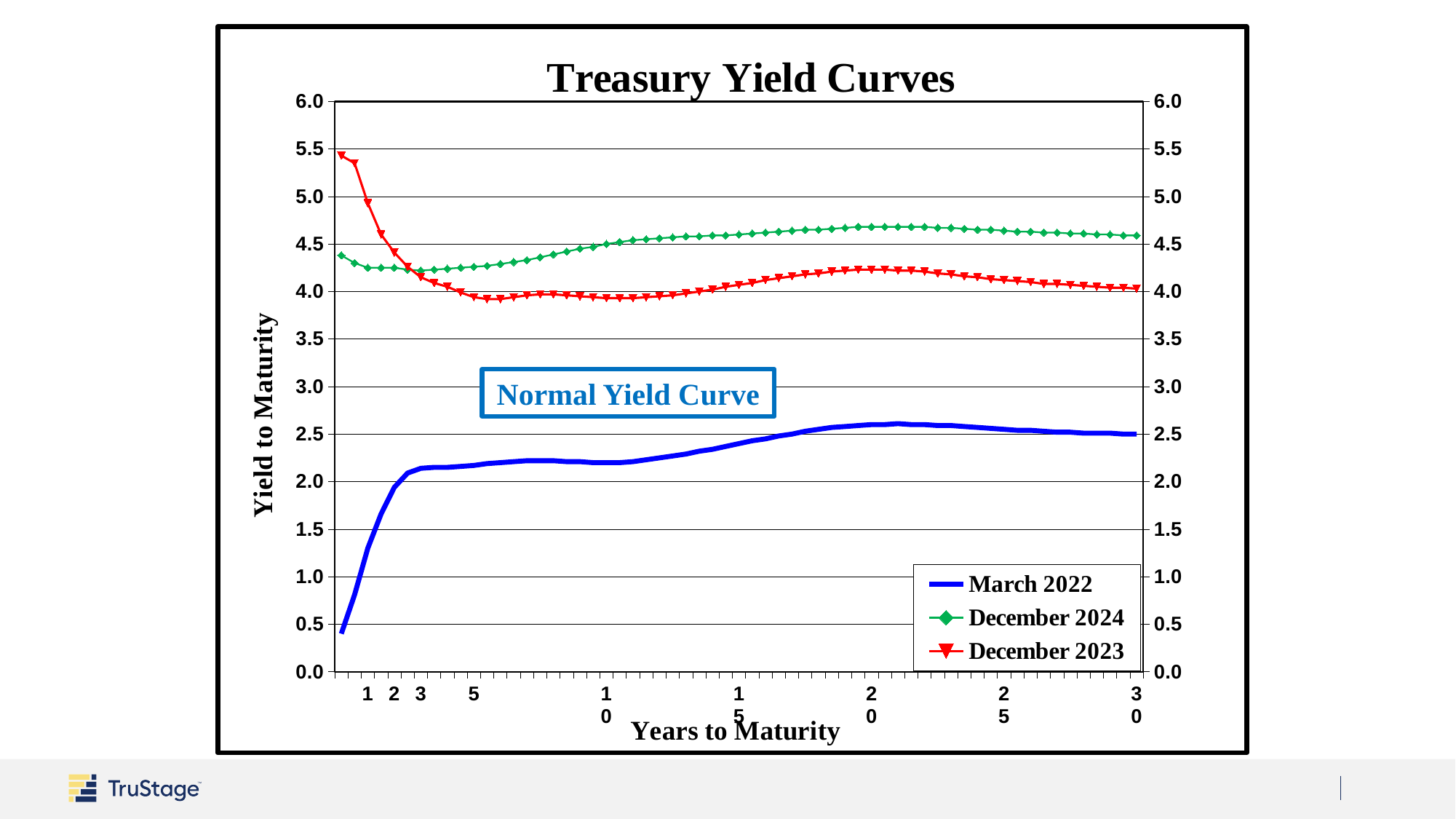
What text appears in the boxed annotation inside the chart? Normal Yield Curve At 30 years to maturity, which is higher: December 2023 or December 2024? December 2024 What is the title of the chart? Treasury Yield Curves How many series does the legend list? 3 At 1 year to maturity, which is higher: December 2023 or December 2024? December 2023 Is the December 2024 yield at 30 years to maturity greater or less than 4.5? greater Which series has the highest yield at 30 years to maturity? December 2024 What kind of chart is shown on the slide? line chart Does the December 2023 yield rise or fall between 1 and 5 years to maturity? fall Is the December 2023 yield at 20 years to maturity greater or less than 4.0? greater Is the March 2022 yield at 10 years to maturity greater or less than 2.5? less Which series has the lowest yields across all maturities? March 2022